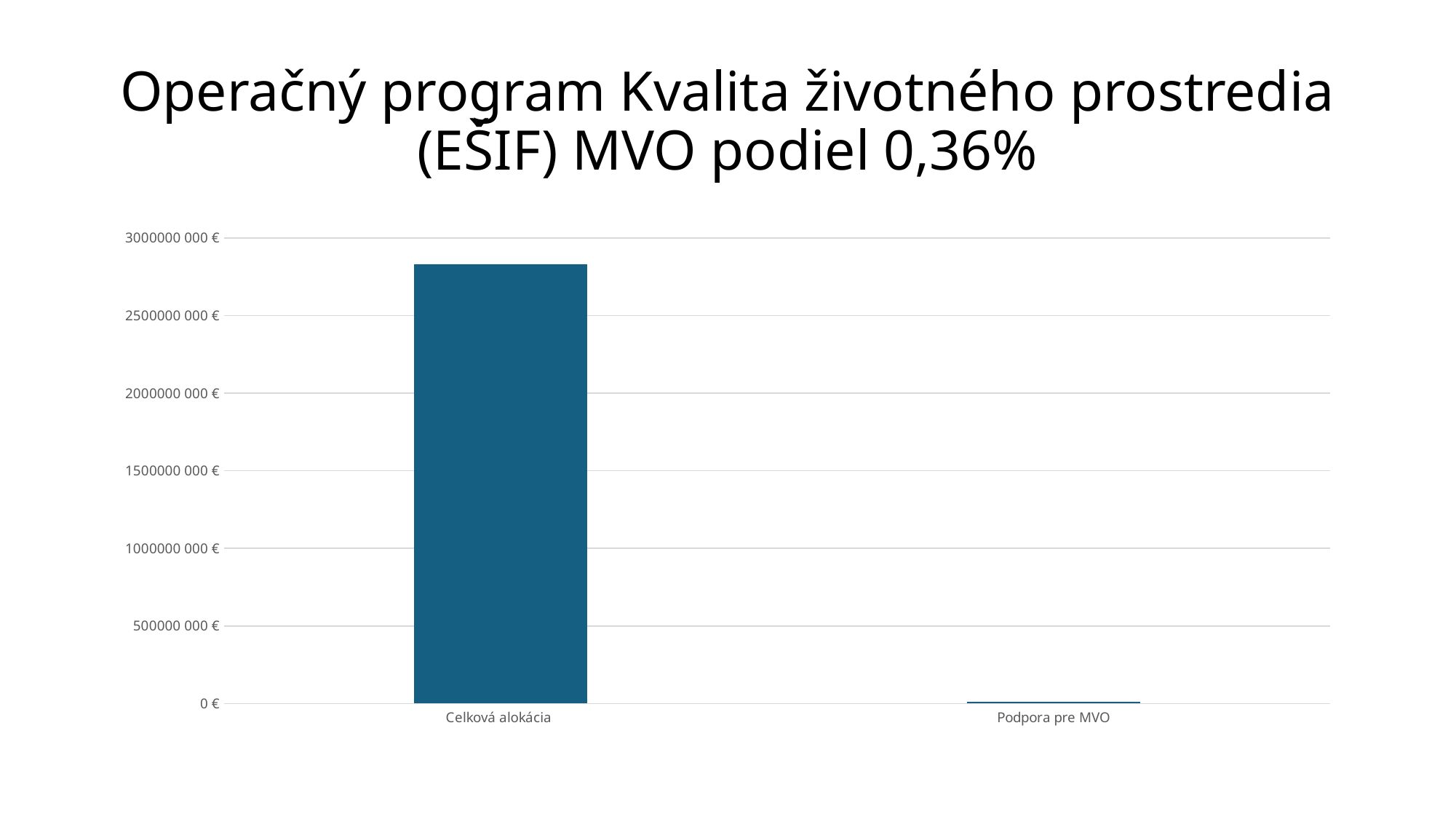
What kind of chart is shown on the slide? bar chart Which category has the lowest value in the chart? Podpora pre MVO How many categories are plotted on the x axis of the chart? 2 Is the value for Celková alokácia greater or less than 2500000 000 €? greater What MVO share (podiel) is stated in the slide title? 0,36% Which is larger, the value for Celková alokácia or the value for Podpora pre MVO? Celková alokácia Is the value for Podpora pre MVO greater or less than 500000 000 €? less Is the value for Celková alokácia greater or less than 3000000 000 €? less What is the highest value shown on the y axis of the chart? 3000000 000 € Which category has the highest value in the chart? Celková alokácia